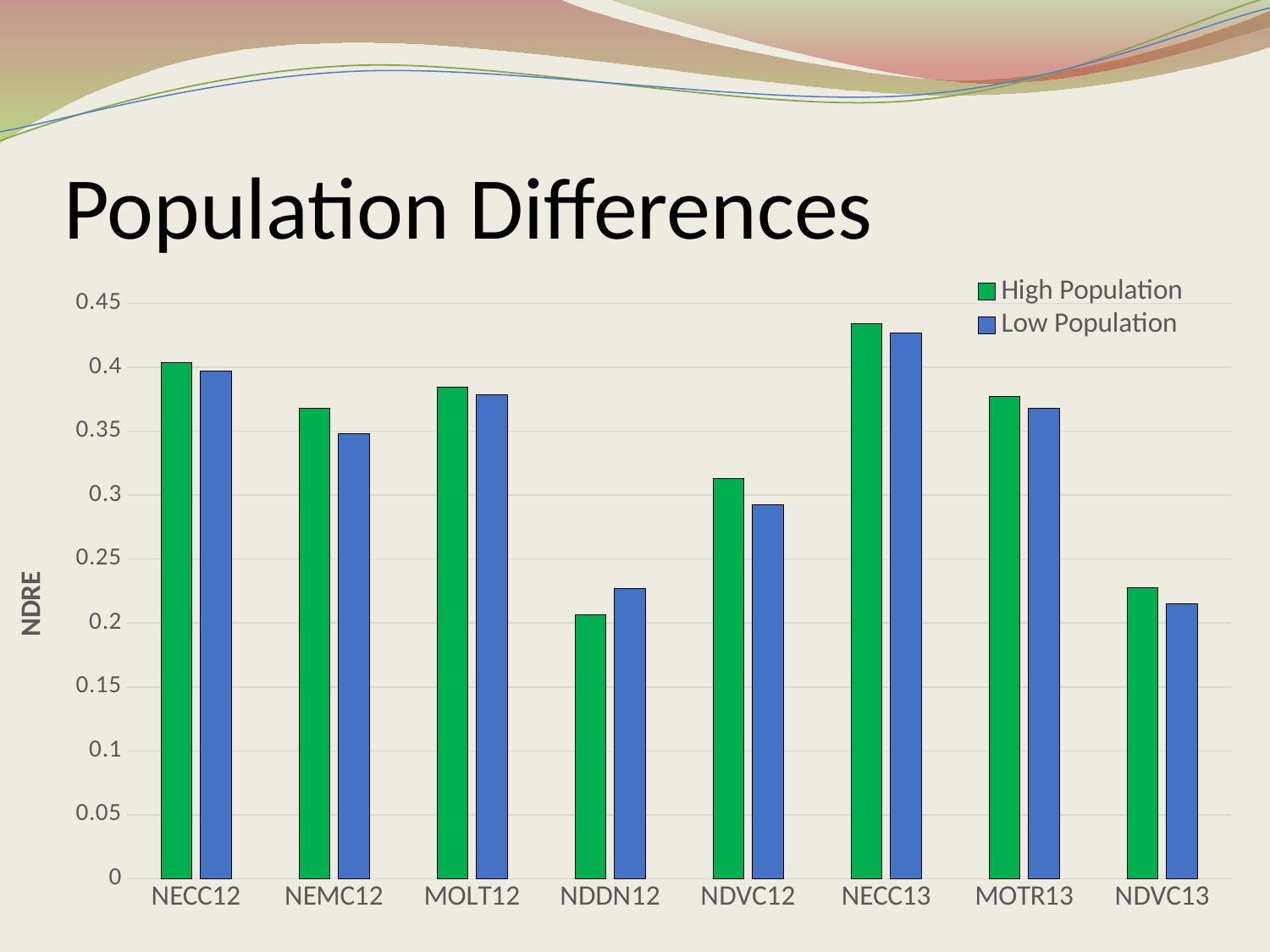
Is the High Population value for NDDN12 greater or less than 0.25? less Which category has the lowest High Population value? NDDN12 Is the Low Population value for NDVC12 greater or less than 0.3? less For NEMC12, which is larger: the High Population value or the Low Population value? High Population What is the label on the vertical axis? NDRE How many categories are shown along the x axis? 8 How many series does the legend list? 2 For NDDN12, which is larger: the High Population value or the Low Population value? Low Population What kind of chart is shown on the slide? Bar chart Which category has the lowest Low Population value? NDVC13 Which category has the highest High Population value? NECC13